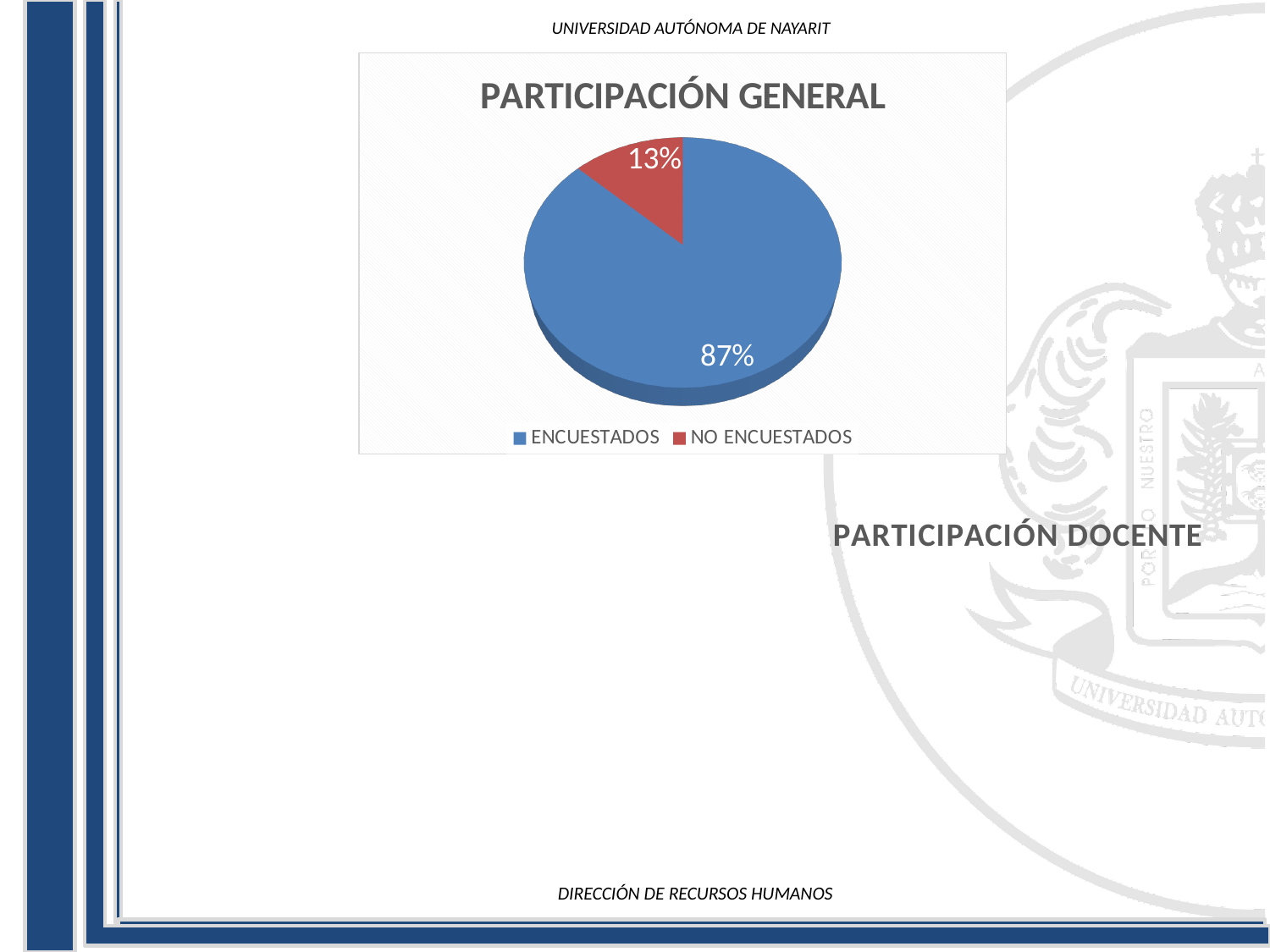
How many entries does the legend list? 2 What kind of chart is shown on the slide? Pie chart How many slices does the pie chart have? 2 What is the difference in percentage points between ENCUESTADOS and NO ENCUESTADOS? 74 Which is larger, the ENCUESTADOS slice or the NO ENCUESTADOS slice? ENCUESTADOS What share of the pie does NO ENCUESTADOS represent? 13% Which category has the largest slice of the pie? ENCUESTADOS What is the title of the chart? PARTICIPACIÓN GENERAL What share of the pie does ENCUESTADOS represent? 87% Which category has the smallest slice of the pie? NO ENCUESTADOS What colour is the NO ENCUESTADOS slice? Red